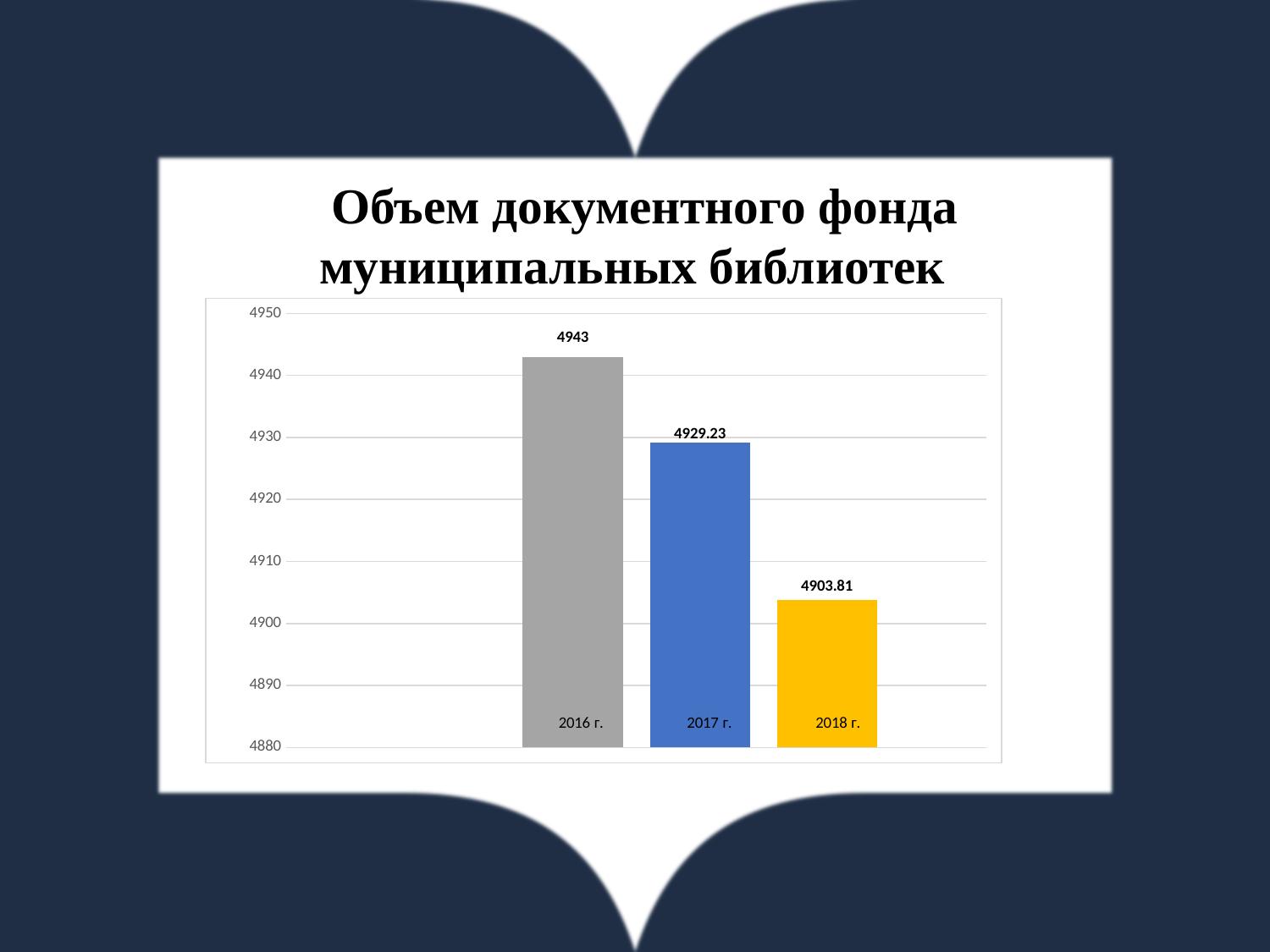
Is the value for 2018 г. greater or less than 4910? less What kind of chart is shown on the slide? bar chart What is the value for 2016 г.? 4943 Do the values rise or fall from 2016 г. to 2018 г.? fall What is the difference between the values for 2016 г. and 2017 г.? 13.77 What is the value for 2018 г.? 4903.81 What is the difference between the values for 2017 г. and 2018 г.? 25.42 Which is larger, the value for 2016 г. or the value for 2018 г.? 2016 г. How many years are shown on the chart? 3 Which year has the highest value? 2016 г. Which year has the lowest value? 2018 г. What is the value for 2017 г.? 4929.23